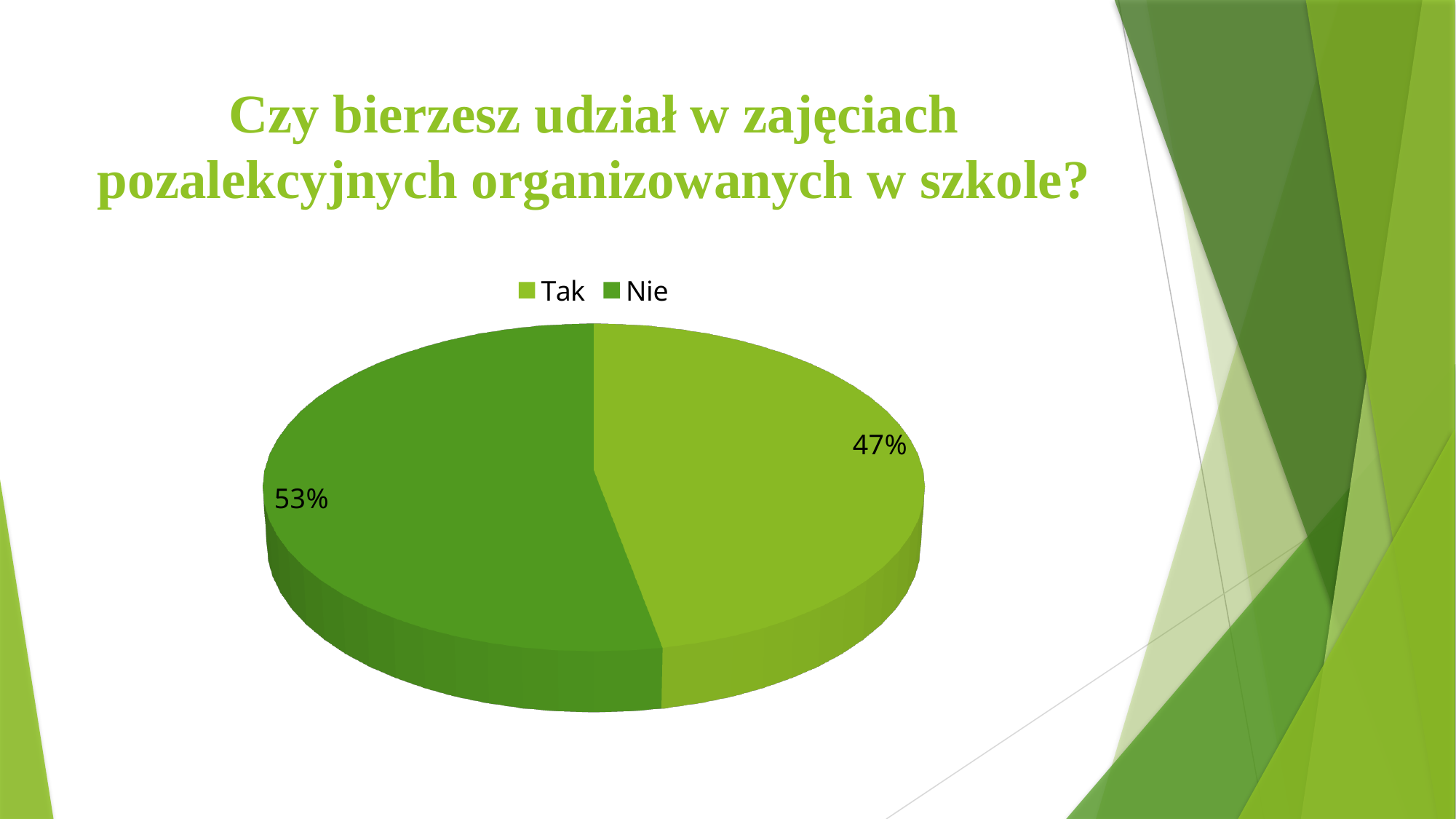
What percentage of the pie is labelled for "Tak"? 47% Which is larger, the share for "Tak" or the share for "Nie"? Nie How many entries does the legend list? 2 Which category has the smallest share of the pie? Tak What type of chart is shown on the slide? pie chart What is the difference in percentage points between "Nie" and "Tak"? 6 Which legend entry is shown in the darker green colour? Nie How many slices does the pie chart have? 2 What percentage of the pie is labelled for "Nie"? 53% Which category has the largest share of the pie? Nie Is the share for "Nie" greater or less than 50%? greater What is the title of the slide above the chart? Czy bierzesz udział w zajęciach pozalekcyjnych organizowanych w szkole?